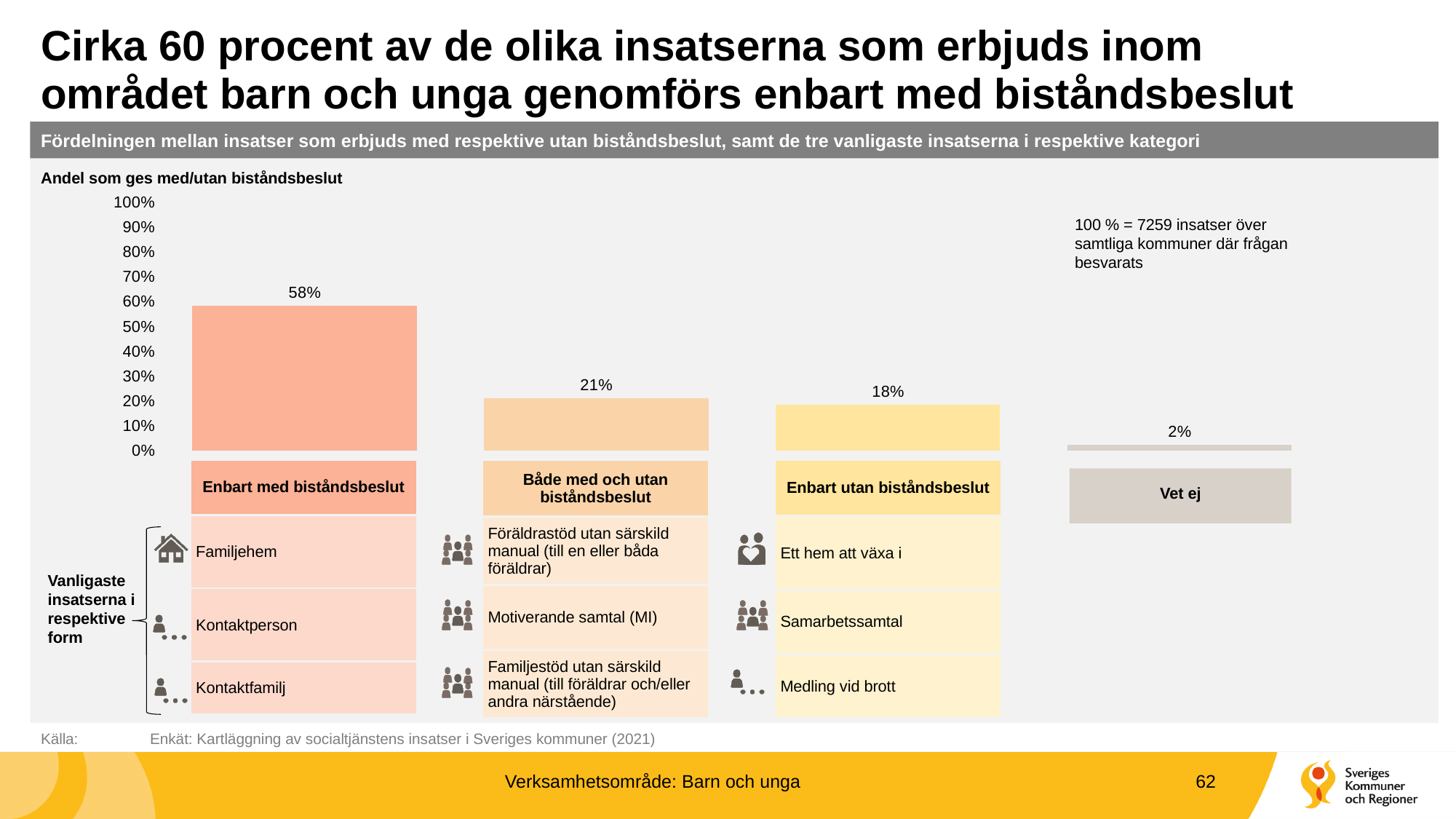
Which is larger, "Både med och utan biståndsbeslut" or "Enbart utan biståndsbeslut"? Både med och utan biståndsbeslut What is the value for "Enbart med biståndsbeslut"? 58% According to the note on the chart, how many insatser does 100% correspond to? 7259 What is the value for "Enbart utan biståndsbeslut"? 18% What kind of chart is shown on the slide? Bar chart What is the value for "Vet ej"? 2% How many categories are shown in the chart? 4 What is the value for "Både med och utan biståndsbeslut"? 21% Which category has the highest value? Enbart med biståndsbeslut What is the difference between "Enbart med biståndsbeslut" and "Enbart utan biståndsbeslut"? 40 percentage points Which category has the lowest value? Vet ej Is the value for "Enbart med biståndsbeslut" greater or less than 50%? greater